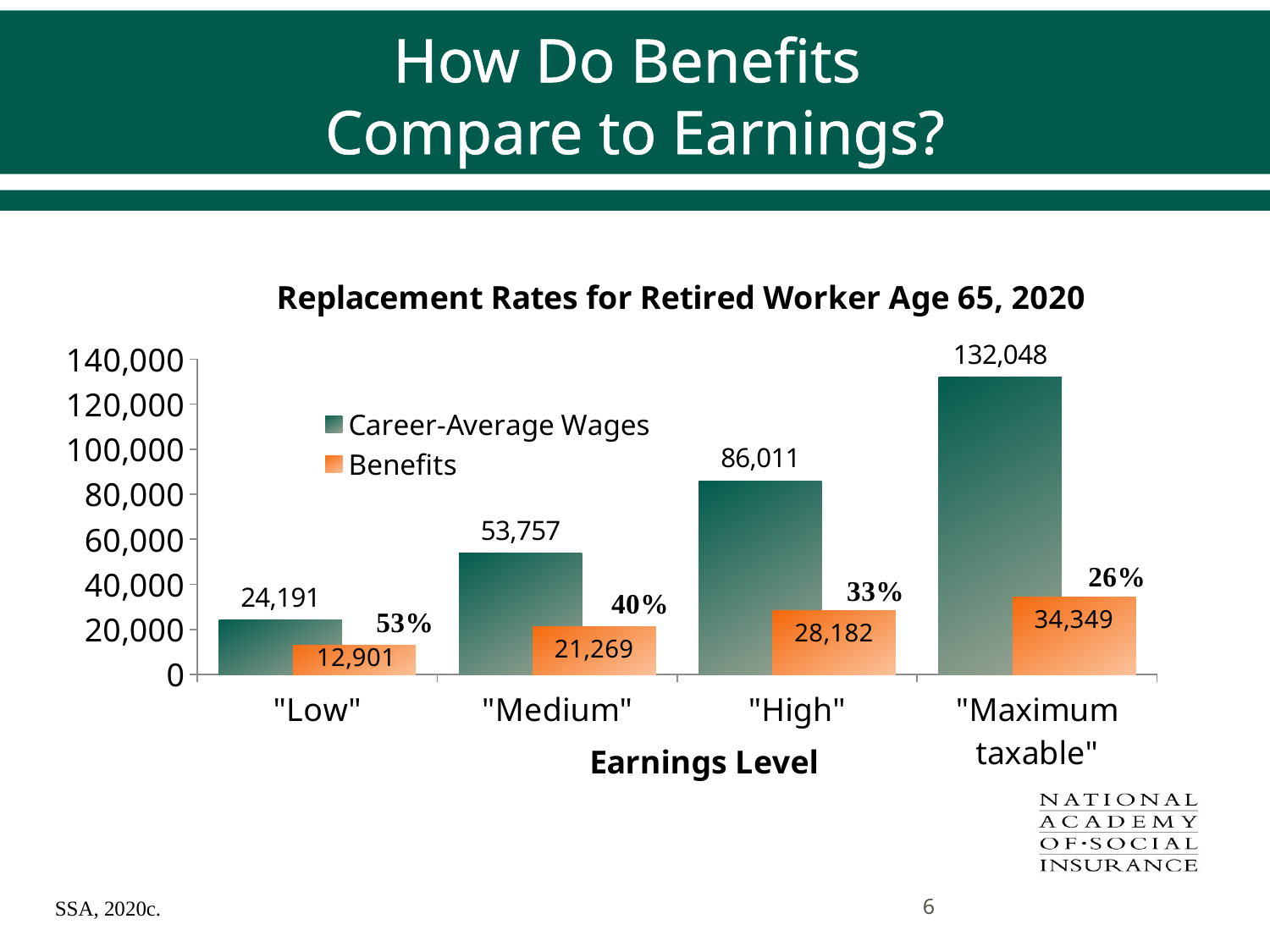
What is the Career-Average Wages value for the "Medium" earnings level? 53,757 What is the Benefits value for the "High" earnings level? 28,182 Which is larger: Benefits for "Maximum taxable" or Career-Average Wages for "Low"? Benefits for "Maximum taxable" What replacement rate percentage is shown for the "Low" earnings level? 53% What kind of chart is shown on the slide? Bar chart Which earnings level has the highest Career-Average Wages? "Maximum taxable" Do the Career-Average Wages values rise or fall from "Low" to "Maximum taxable"? Rise Which earnings level has the lowest Benefits value? "Low" How many earnings levels are shown on the x axis? 4 What is the difference between Career-Average Wages and Benefits for the "Low" earnings level? 11,290 How many series does the legend list? 2 What is the Career-Average Wages value for the "Maximum taxable" earnings level? 132,048